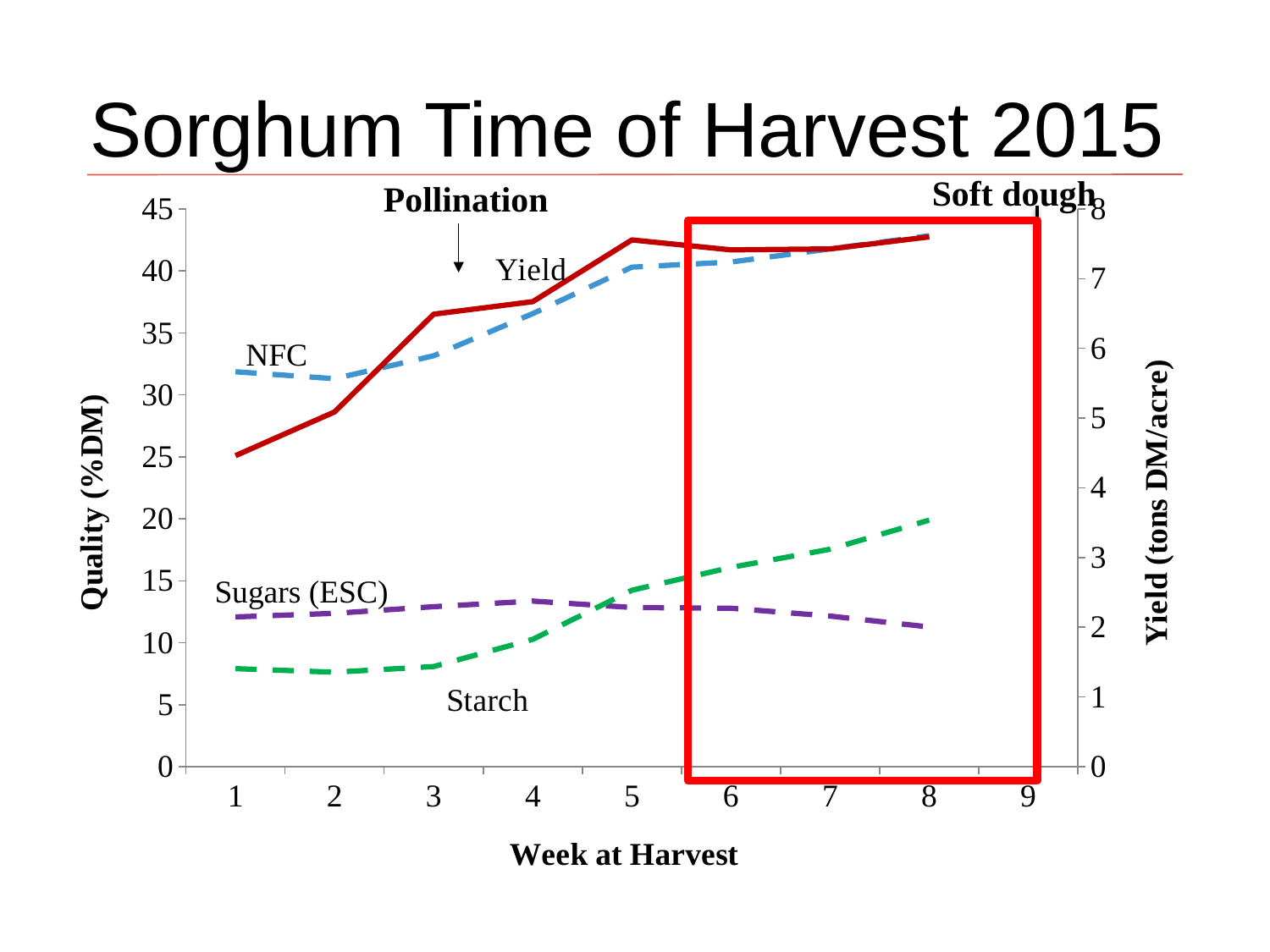
Is the Starch value at week 1 greater or less than 10 %DM? less Does the NFC line rise or fall from week 1 to week 8? rises At week 8, which is larger, the Starch value or the Sugars (ESC) value? Starch Is the Yield value at week 8 greater or less than 7 tons DM/acre? greater Is the NFC value at week 1 greater or less than 30 %DM? greater How many lines (series) are plotted on the chart? 4 What is the title of the slide's chart? Sorghum Time of Harvest 2015 What kind of chart is shown on the slide? line chart What is the label of the x axis? Week at Harvest Does the Starch line rise or fall from week 1 to week 8? rises Among the quality series (NFC, Sugars (ESC), Starch), which has the lowest value at week 1? Starch